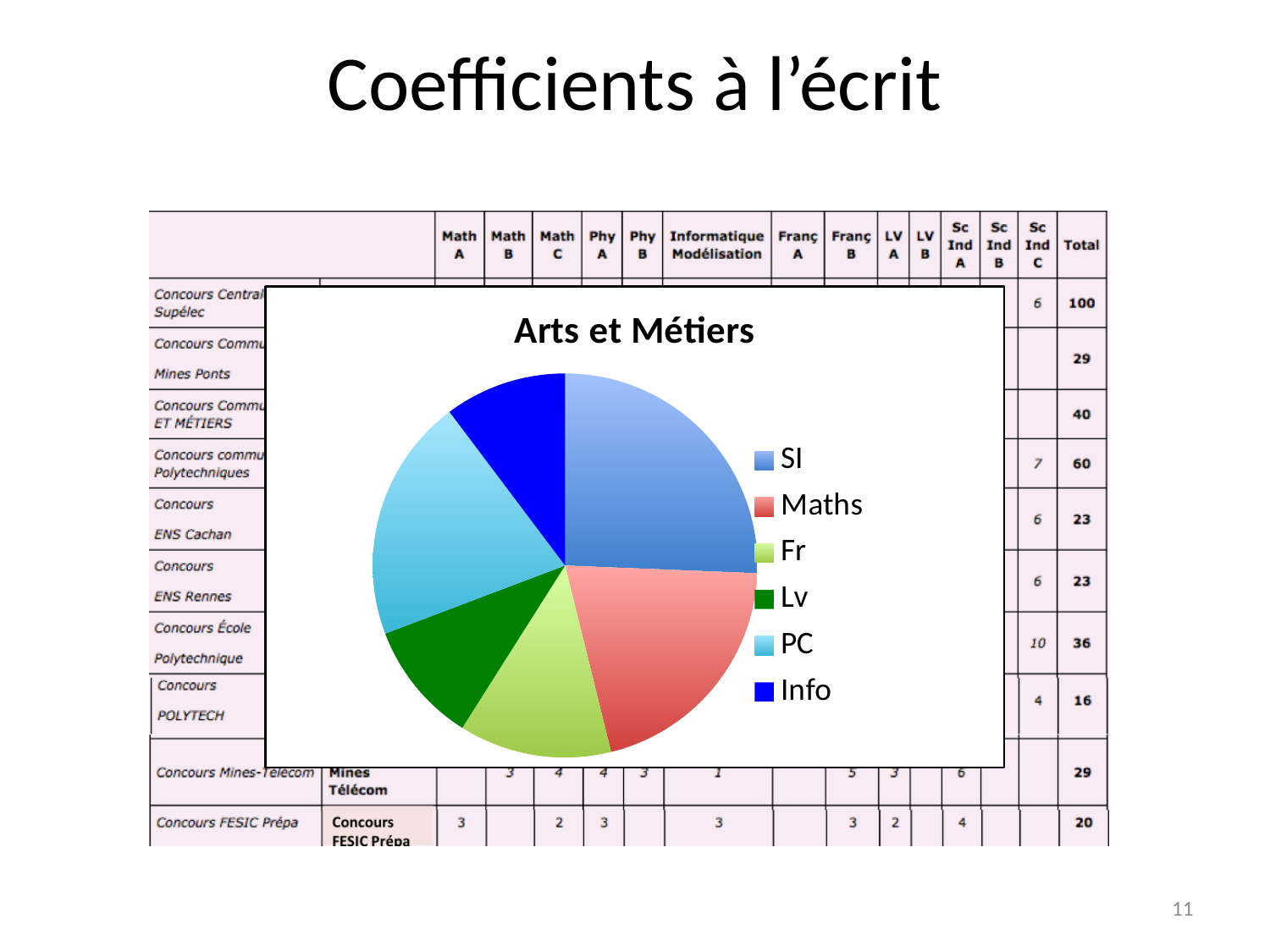
What kind of chart is shown on the slide? pie chart What colour is the Maths slice in the pie chart? red Which slice is larger in the pie chart, PC or Info? PC How many entries does the legend of the pie chart list? 6 Which slice is larger in the pie chart, Maths or Fr? Maths Which category has the largest slice in the pie chart? SI What is the title of the pie chart? Arts et Métiers Which slice is larger in the pie chart, SI or Fr? SI How many slices does the pie chart have? 6